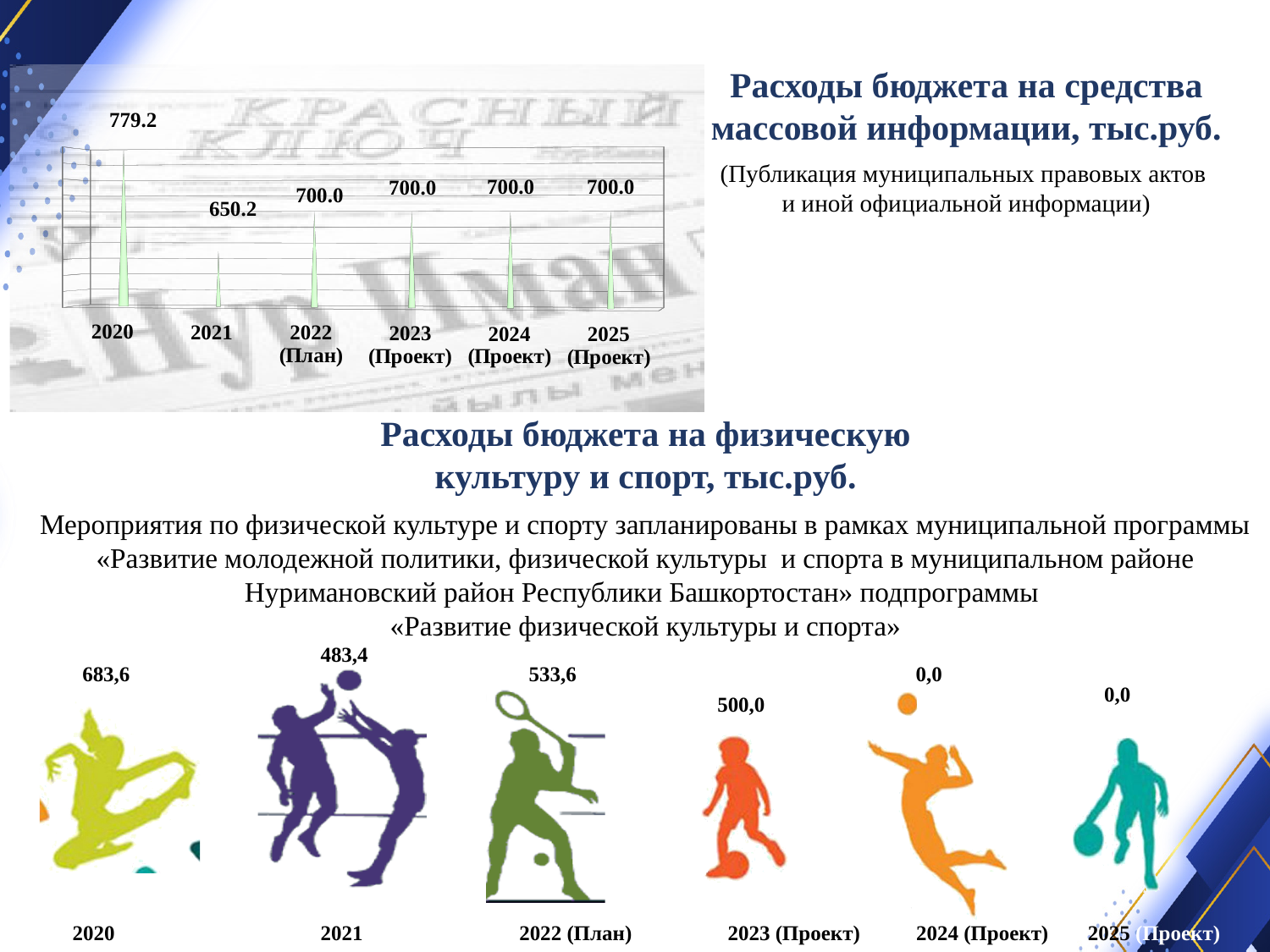
In the chart 'Расходы бюджета на средства массовой информации, тыс.руб.', how many years are shown on the x axis? 6 In the chart 'Расходы бюджета на физическую культуру и спорт, тыс.руб.', which is larger: the value for 2021 or the value for 2023 (Проект)? 2023 (Проект) In the chart 'Расходы бюджета на физическую культуру и спорт, тыс.руб.', what is the difference between the 2020 value and the 2021 value? 200,2 In the chart 'Расходы бюджета на физическую культуру и спорт, тыс.руб.', what is the value for 2022 (План)? 533,6 In the chart 'Расходы бюджета на средства массовой информации, тыс.руб.', which year has the lowest value? 2021 In the chart 'Расходы бюджета на средства массовой информации, тыс.руб.', what is the value for 2020? 779.2 In the chart 'Расходы бюджета на средства массовой информации, тыс.руб.', what is the difference between the 2020 value and the 2021 value? 129.0 In the chart 'Расходы бюджета на физическую культуру и спорт, тыс.руб.', what is the value for 2020? 683,6 In the chart 'Расходы бюджета на средства массовой информации, тыс.руб.', which year has the highest value? 2020 In the chart 'Расходы бюджета на средства массовой информации, тыс.руб.', what is the value for 2023 (Проект)? 700.0 What kind of chart is 'Расходы бюджета на средства массовой информации, тыс.руб.'? bar chart In the chart 'Расходы бюджета на средства массовой информации, тыс.руб.', what is the value for 2021? 650.2